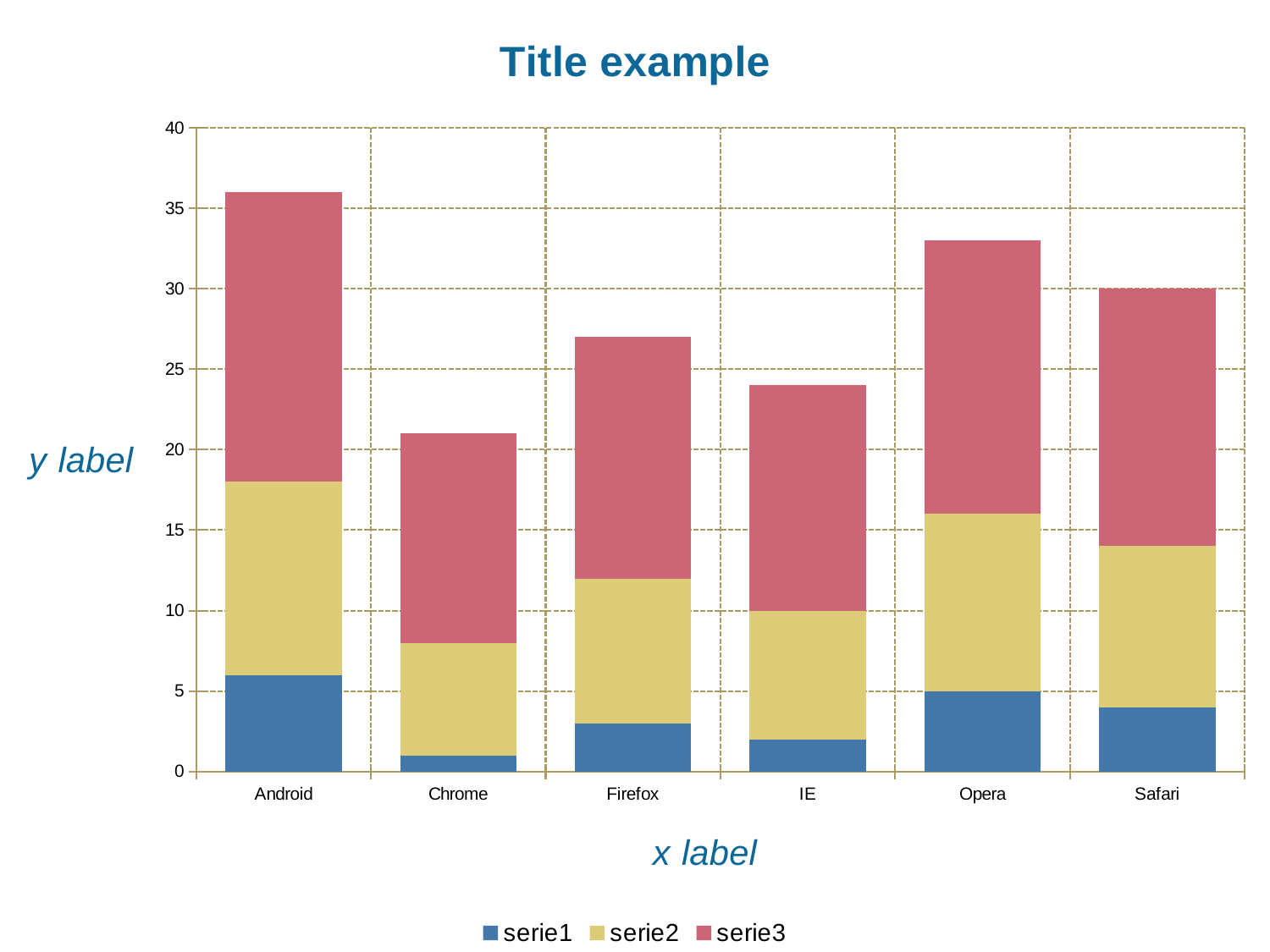
Is the total stacked bar for IE greater or less than 25? less Is the total stacked bar for Android greater or less than 35? greater Which has a larger serie1 value, Android or Chrome? Android How many series does the legend list? 3 Which category has the lowest total stacked bar? Chrome What kind of chart is shown on the slide? stacked bar chart What is the title of the chart? Title example How many categories are shown on the x axis? 6 Which has a larger total stacked bar, Opera or Firefox? Opera What is the value of serie1 for Opera? 5 What is the total of the stacked bar for Safari? 30 Which category has the highest total stacked bar? Android